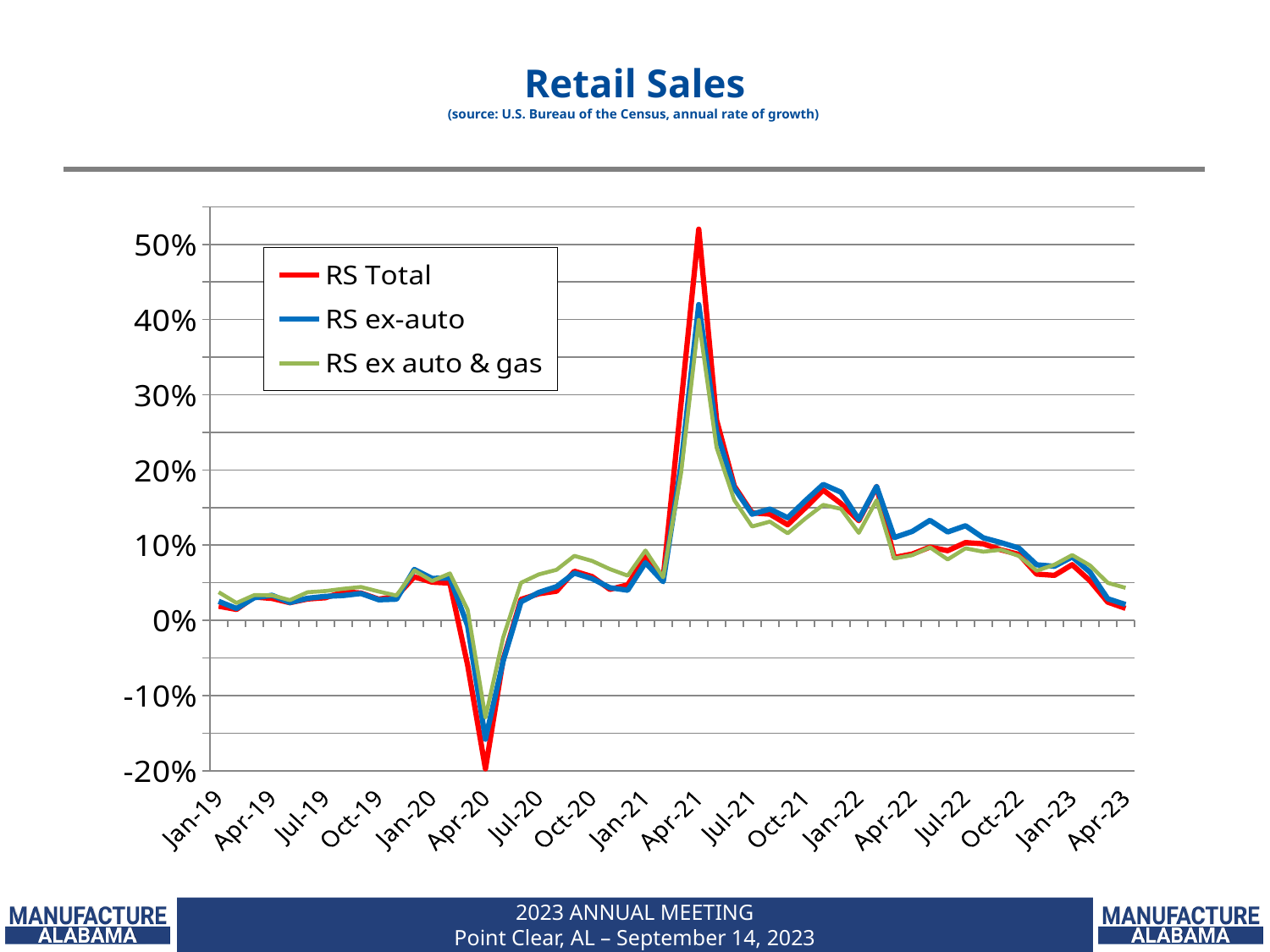
How many series does the legend list? 3 Which series reaches the highest peak around Apr-21? RS Total Is the value of RS ex-auto around Apr-20 greater or less than -10%? less Which series drops to the lowest value around Apr-20? RS Total What is the title of the chart? Retail Sales Which colour is used for the RS Total series? red Does the RS Total series generally rise or fall from Apr-21 to Apr-23? fall Is the value of RS Total at Apr-23 greater or less than 10%? less Is the peak value of RS Total around Apr-21 greater or less than 50%? greater What kind of chart is shown on the slide? line chart Around Apr-21, which is larger: RS Total or RS ex-auto? RS Total